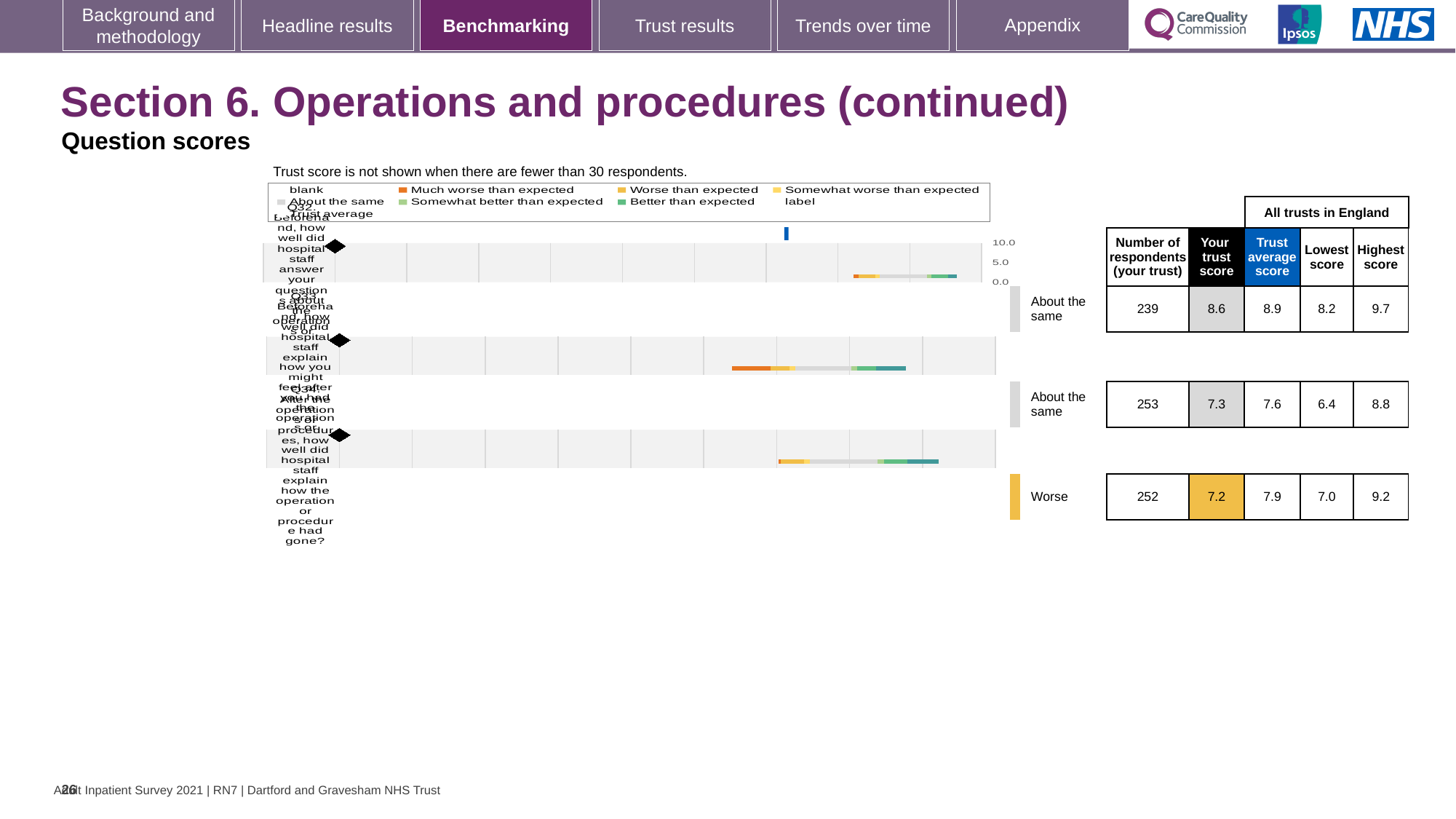
What benchmark category is shown for the bottom chart (Q34)? Worse What kind of chart is used to show the question scores on this slide? Bar chart For the top chart (Q32), how many respondents does the table show for your trust? 239 Which of the three question charts has the highest 'Your trust score'? The top chart (Q32), 8.6 For the middle chart (Q33), what is the trust average score shown in the table? 7.6 How many question charts are shown on the slide? 3 For the top chart (Q32), what is the 'Your trust score' shown in the table? 8.6 For the top chart (Q32), what is the difference between the highest score and the lowest score across all trusts in England? 1.5 For the middle chart (Q33), which is larger: your trust score or the trust average score? Trust average score (7.6) For the bottom chart (Q34), what is the highest score across all trusts in England? 9.2 For the bottom chart (Q34), what is the lowest score across all trusts in England? 7.0 For the bottom chart (Q34), how much higher is the trust average score than your trust score? 0.7